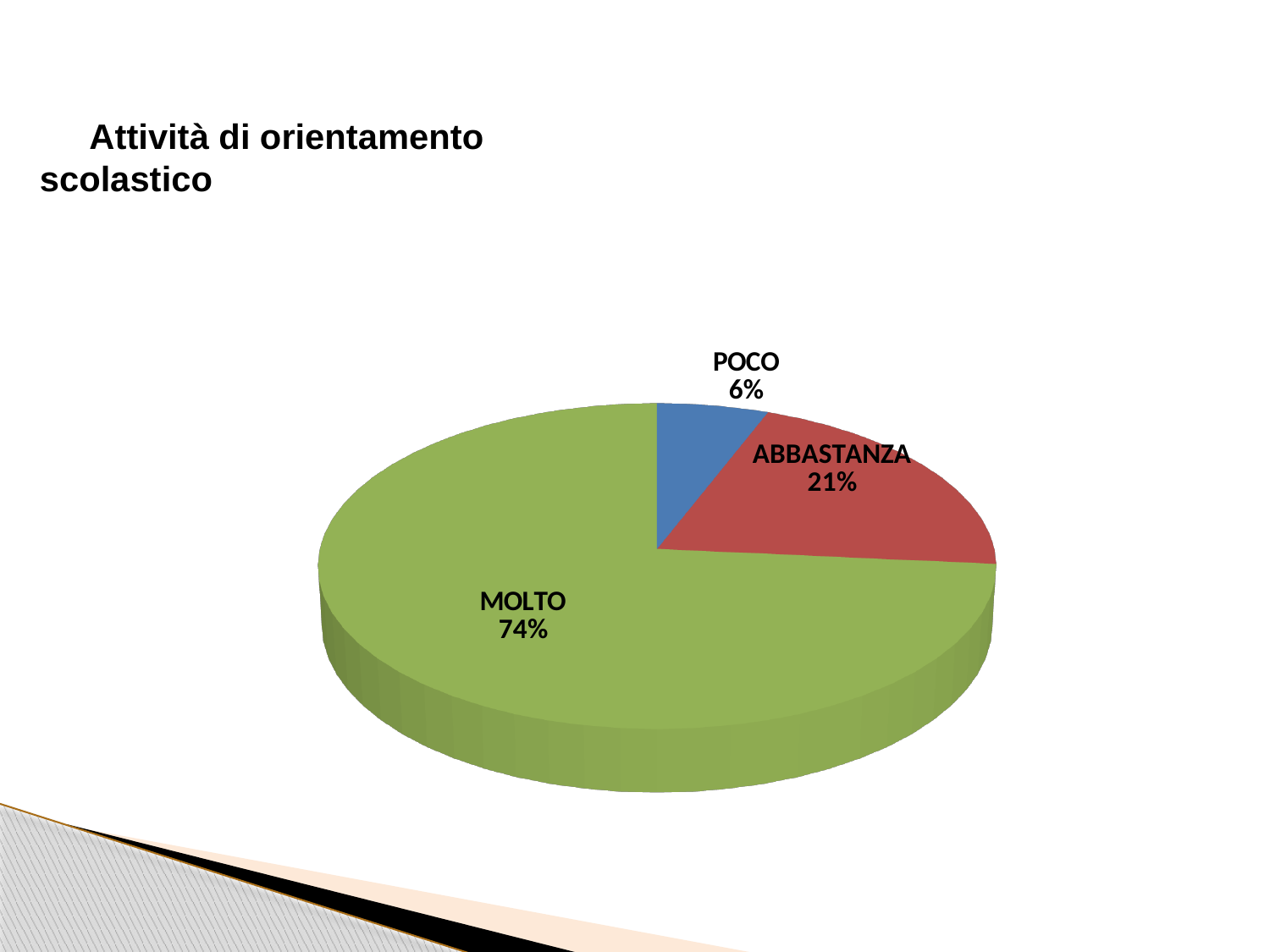
Which category has the largest slice of the pie? MOLTO What is the difference in percentage points between MOLTO and ABBASTANZA? 53 What kind of chart is shown on the slide? pie chart How many slices does the pie chart have? 3 Which category has the smallest slice of the pie? POCO What share of the pie does ABBASTANZA represent? 21% Which is larger, the share for ABBASTANZA or the share for POCO? ABBASTANZA What is the difference in percentage points between ABBASTANZA and POCO? 15 What share of the pie does POCO represent? 6% What share of the pie does MOLTO represent? 74% What is the title shown above the chart on the slide? Attività di orientamento scolastico What colour is the MOLTO slice of the pie? green